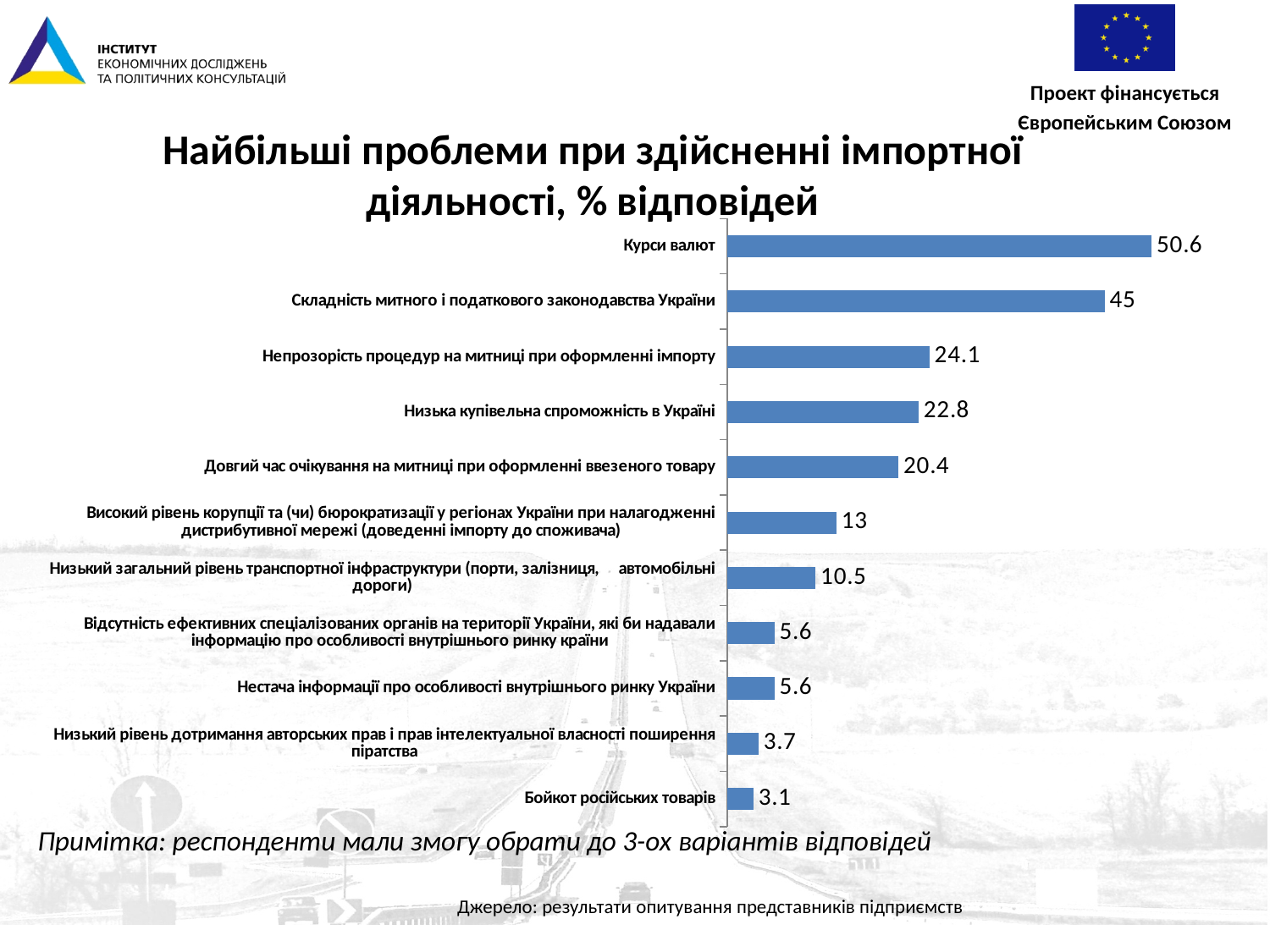
What is the value for "Низька купівельна спроможність в Україні"? 22.8 What is the title of the chart? Найбільші проблеми при здійсненні імпортної діяльності, % відповідей Which category has the lowest value? Бойкот російських товарів Which is larger: the value for "Непрозорість процедур на митниці при оформленні імпорту" or for "Довгий час очікування на митниці при оформленні ввезеного товару"? Непрозорість процедур на митниці при оформленні імпорту Which category has the highest value? Курси валют What is the difference between the values for "Курси валют" and "Складність митного і податкового законодавства України"? 5.6 What is the value for "Низький загальний рівень транспортної інфраструктури (порти, залізниця, автомобільні дороги)"? 10.5 What is the value for "Бойкот російських товарів"? 3.1 What kind of chart is shown on the slide? Bar chart What is the value for "Курси валют"? 50.6 How many categories are shown in the chart? 11 What is the difference between the values for "Високий рівень корупції та (чи) бюрократизації у регіонах України при налагодженні дистрибутивної мережі" and "Нестача інформації про особливості внутрішнього ринку України"? 7.4